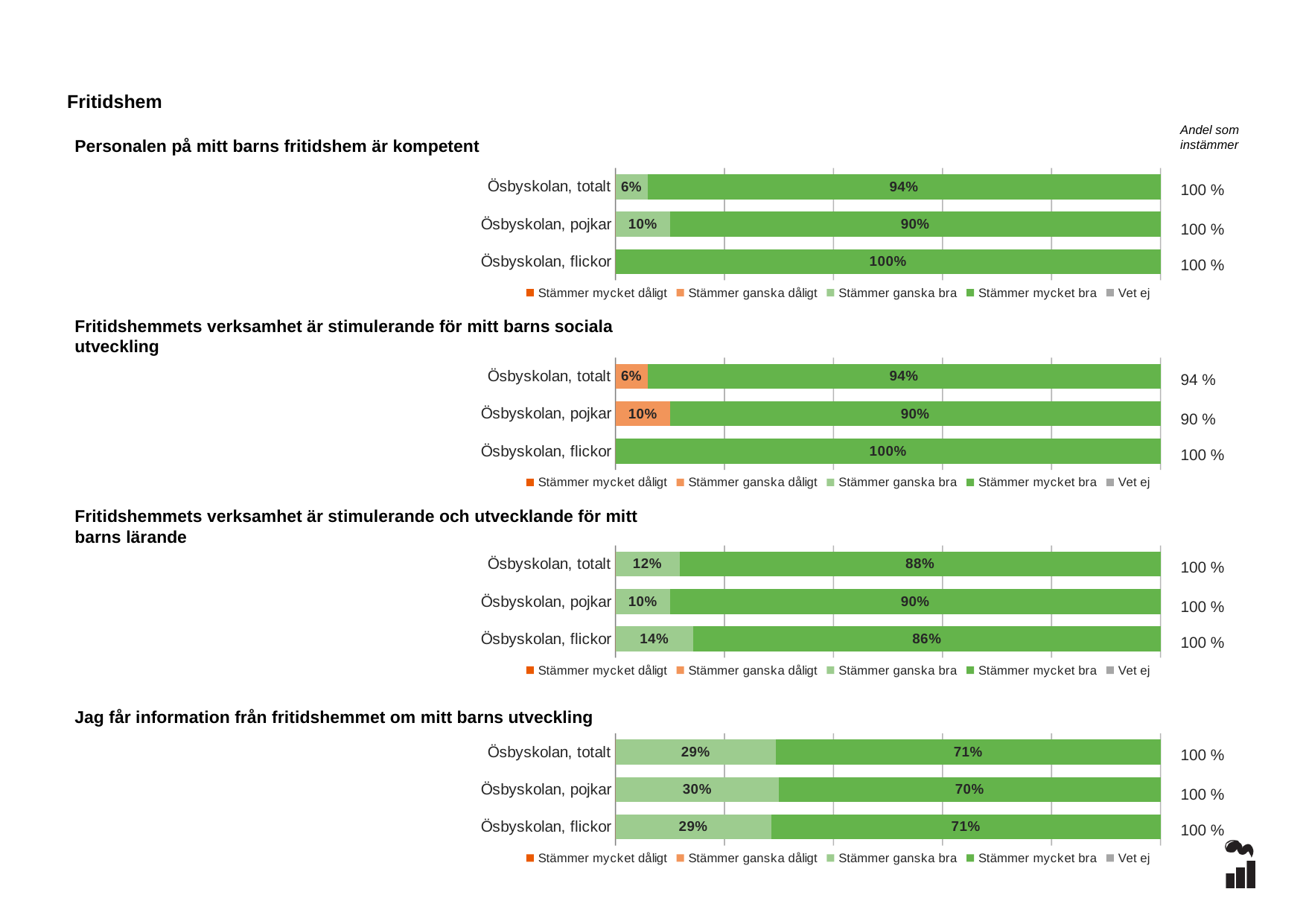
In the chart 'Jag får information från fritidshemmet om mitt barns utveckling', which is larger: the 'Stämmer mycket bra' value for Ösbyskolan, totalt or for Ösbyskolan, pojkar? Ösbyskolan, totalt How many series does the legend list for the chart 'Jag får information från fritidshemmet om mitt barns utveckling'? 5 How many categories are shown in the chart 'Personalen på mitt barns fritidshem är kompetent'? 3 In the chart 'Fritidshemmets verksamhet är stimulerande och utvecklande för mitt barns lärande', what is the difference between the 'Stämmer mycket bra' values for Ösbyskolan, pojkar and Ösbyskolan, flickor? 4% In the chart 'Fritidshemmets verksamhet är stimulerande och utvecklande för mitt barns lärande', what is the 'Stämmer ganska bra' value for Ösbyskolan, flickor? 14% In the chart 'Fritidshemmets verksamhet är stimulerande och utvecklande för mitt barns lärande', which category has the lowest 'Stämmer mycket bra' value? Ösbyskolan, flickor In the chart 'Personalen på mitt barns fritidshem är kompetent', what is the 'Stämmer ganska bra' value for Ösbyskolan, pojkar? 10% In the chart 'Jag får information från fritidshemmet om mitt barns utveckling', what is the total of the stacked bar for Ösbyskolan, flickor? 100% In the chart 'Fritidshemmets verksamhet är stimulerande för mitt barns sociala utveckling', which category has the highest 'Stämmer mycket bra' value? Ösbyskolan, flickor In the chart 'Fritidshemmets verksamhet är stimulerande för mitt barns sociala utveckling', what is the 'Stämmer ganska dåligt' value for Ösbyskolan, totalt? 6% In the chart 'Personalen på mitt barns fritidshem är kompetent', what is the 'Stämmer mycket bra' value for Ösbyskolan, totalt? 94% In the chart 'Jag får information från fritidshemmet om mitt barns utveckling', what is the 'Stämmer ganska bra' value for Ösbyskolan, pojkar? 30%